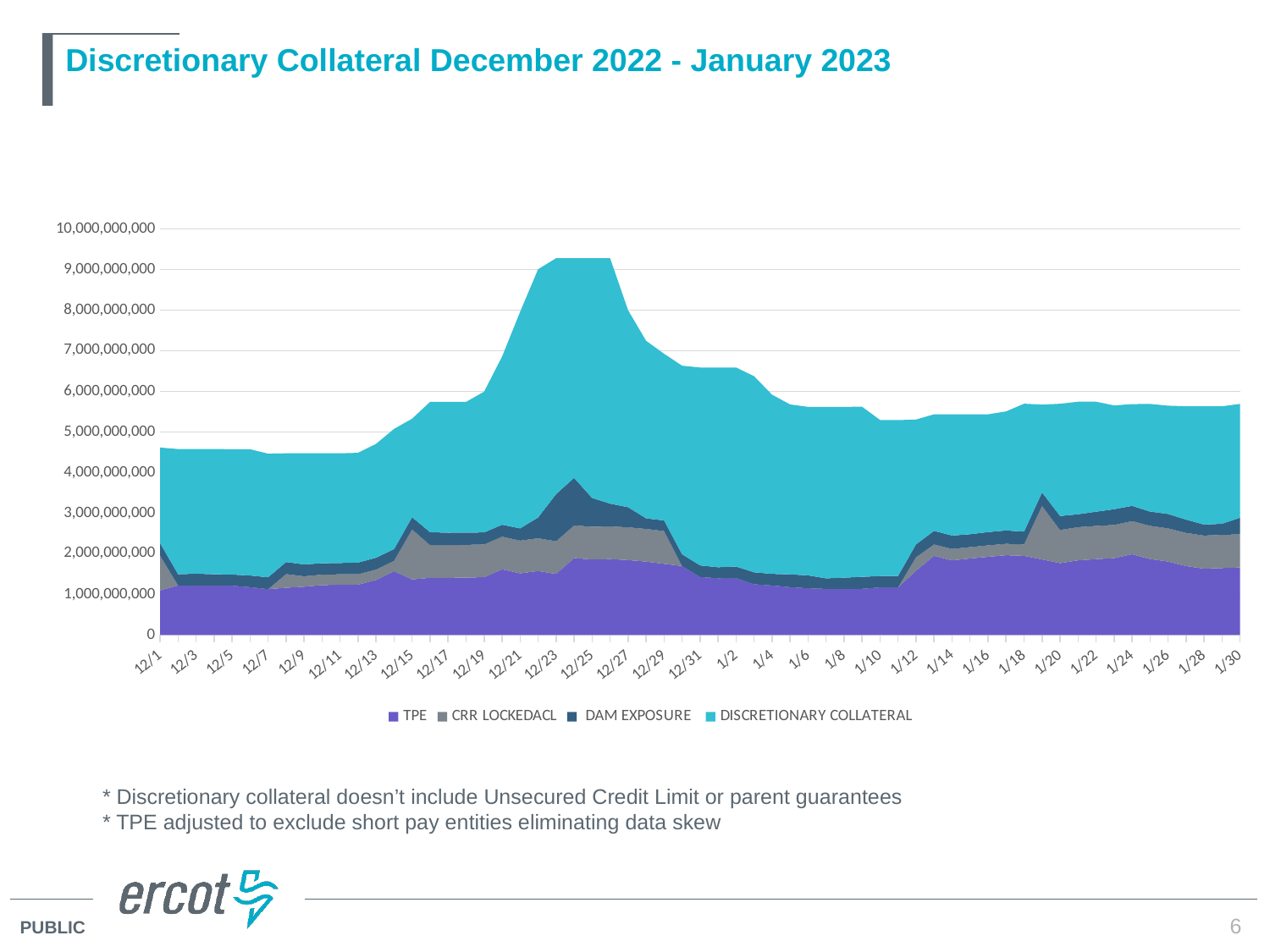
How many series does the legend list? 4 What kind of chart is shown on the slide? Stacked area chart Which series is shown in purple at the bottom of the stack? TPE Is the total stacked value on 1/30 greater or less than 5,000,000,000? greater Does the total stacked value rise or fall from 12/25 to 12/31? fall Is the total stacked value on 12/1 greater or less than 5,000,000,000? less Is the total stacked value on 1/30 greater or less than 6,000,000,000? less Which date has the larger total stacked value, 12/1 or 12/24? 12/24 What is the title of the chart? Discretionary Collateral December 2022 - January 2023 Does the total stacked value rise or fall from 12/13 to 12/23? rise